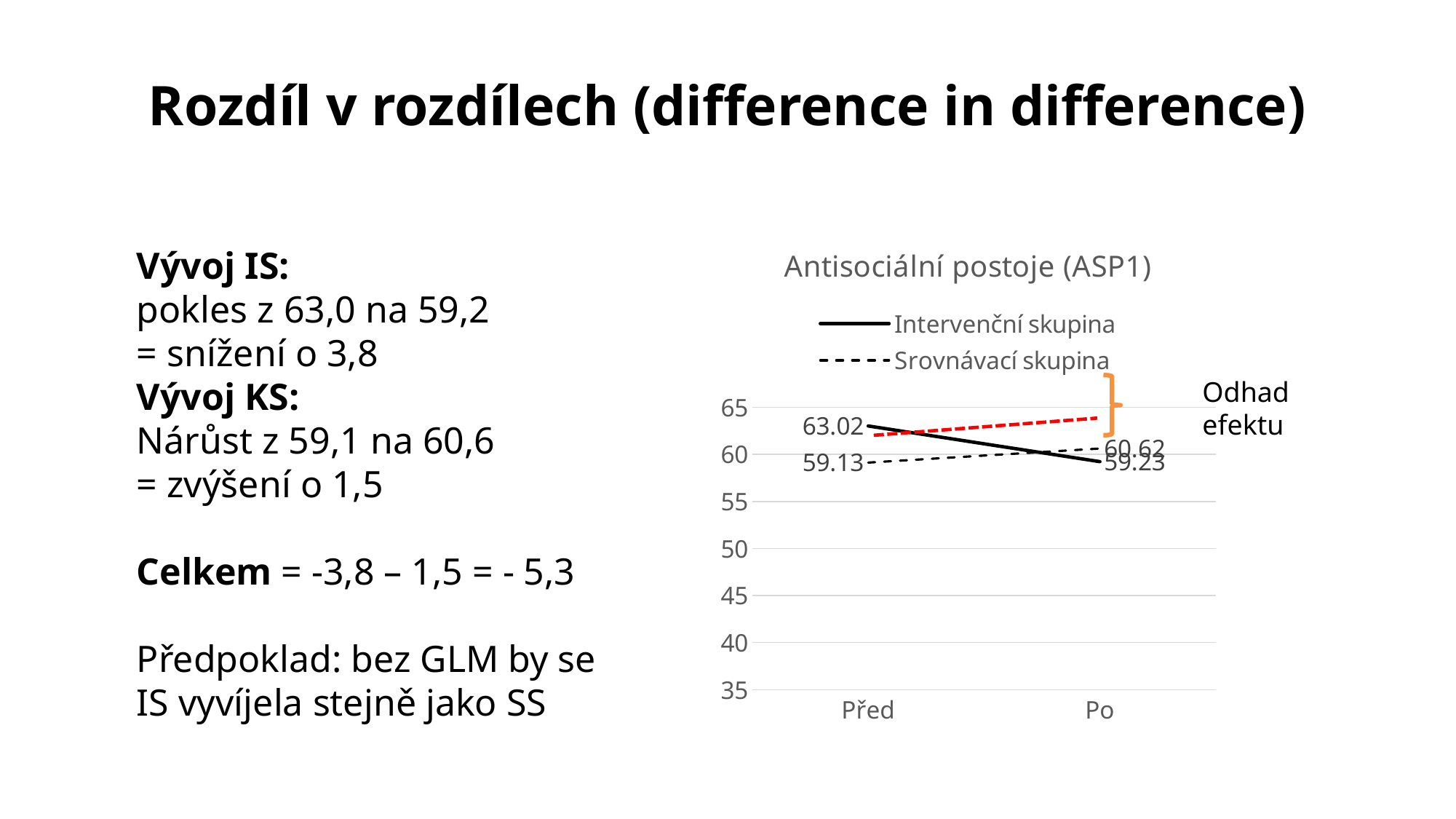
What is the difference between the Intervenční skupina values at Před and Po? 3.79 What is the value for Srovnávací skupina at Po? 60.62 What is the value for Srovnávací skupina at Před? 59.13 Does the Srovnávací skupina line rise or fall from Před to Po? rise What is the value for Intervenční skupina at Před? 63.02 At Před, which series has the larger value, Intervenční skupina or Srovnávací skupina? Intervenční skupina How many categories are shown on the x axis of the chart? 2 What type of chart is shown on the slide? line chart Does the Intervenční skupina line rise or fall from Před to Po? fall What is the value for Intervenční skupina at Po? 59.23 How many series does the chart legend list? 2 What is the title of the chart? Antisociální postoje (ASP1)